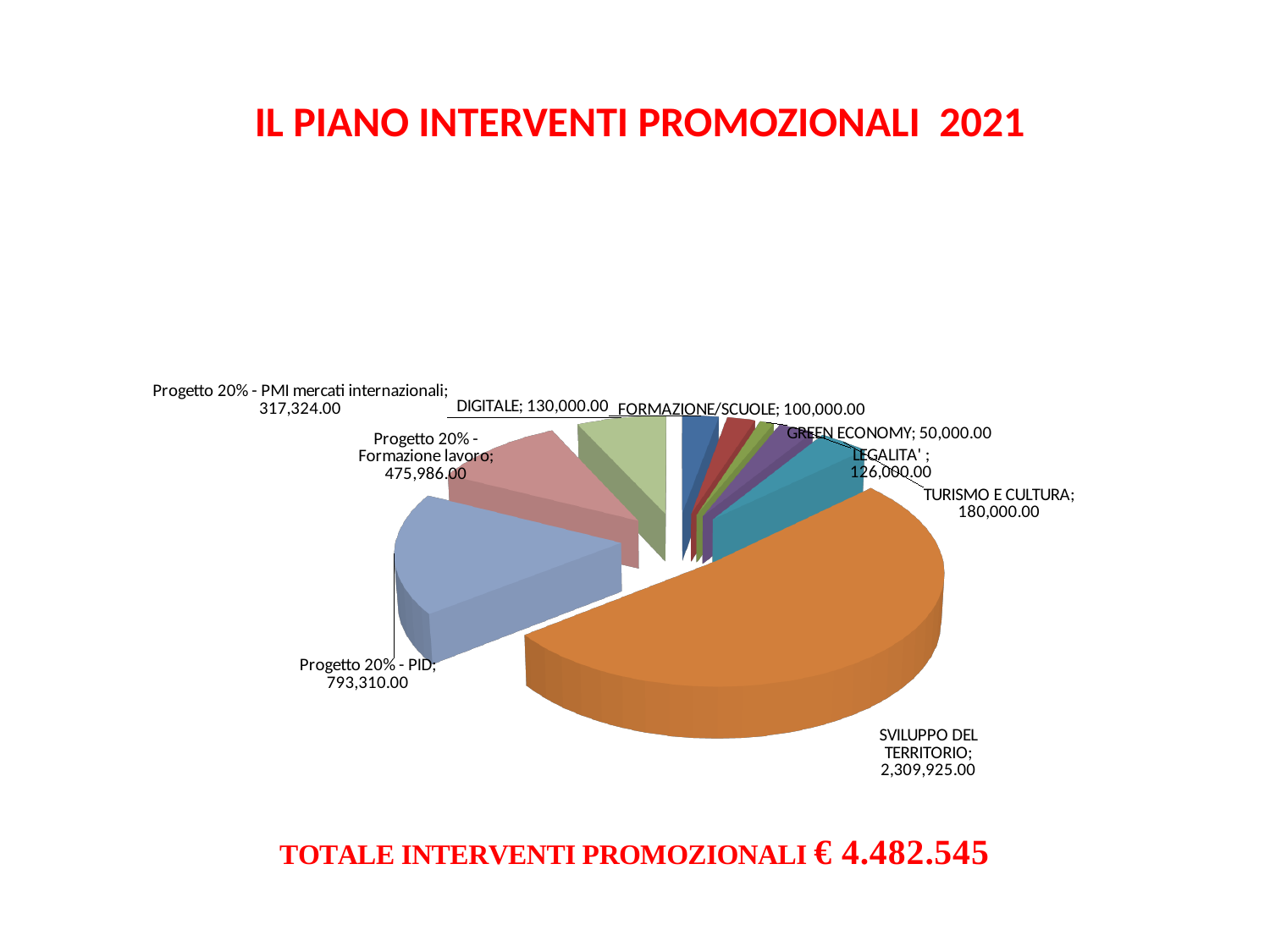
What kind of chart is shown on the slide? Pie chart What is the difference between TURISMO E CULTURA and DIGITALE? 50,000.00 Which category has the largest slice? SVILUPPO DEL TERRITORIO What is the total of all interventi promozionali shown on the slide? € 4.482.545 What is the value for Progetto 20% - PMI mercati internazionali? 317,324.00 What is the value for LEGALITA'? 126,000.00 How many slices does the pie chart have? 9 What is the value for Progetto 20% - PID? 793,310.00 Which category has the smallest slice? GREEN ECONOMY Which is larger, DIGITALE or LEGALITA'? DIGITALE What is the title of the slide? IL PIANO INTERVENTI PROMOZIONALI 2021 What is the value for SVILUPPO DEL TERRITORIO? 2,309,925.00